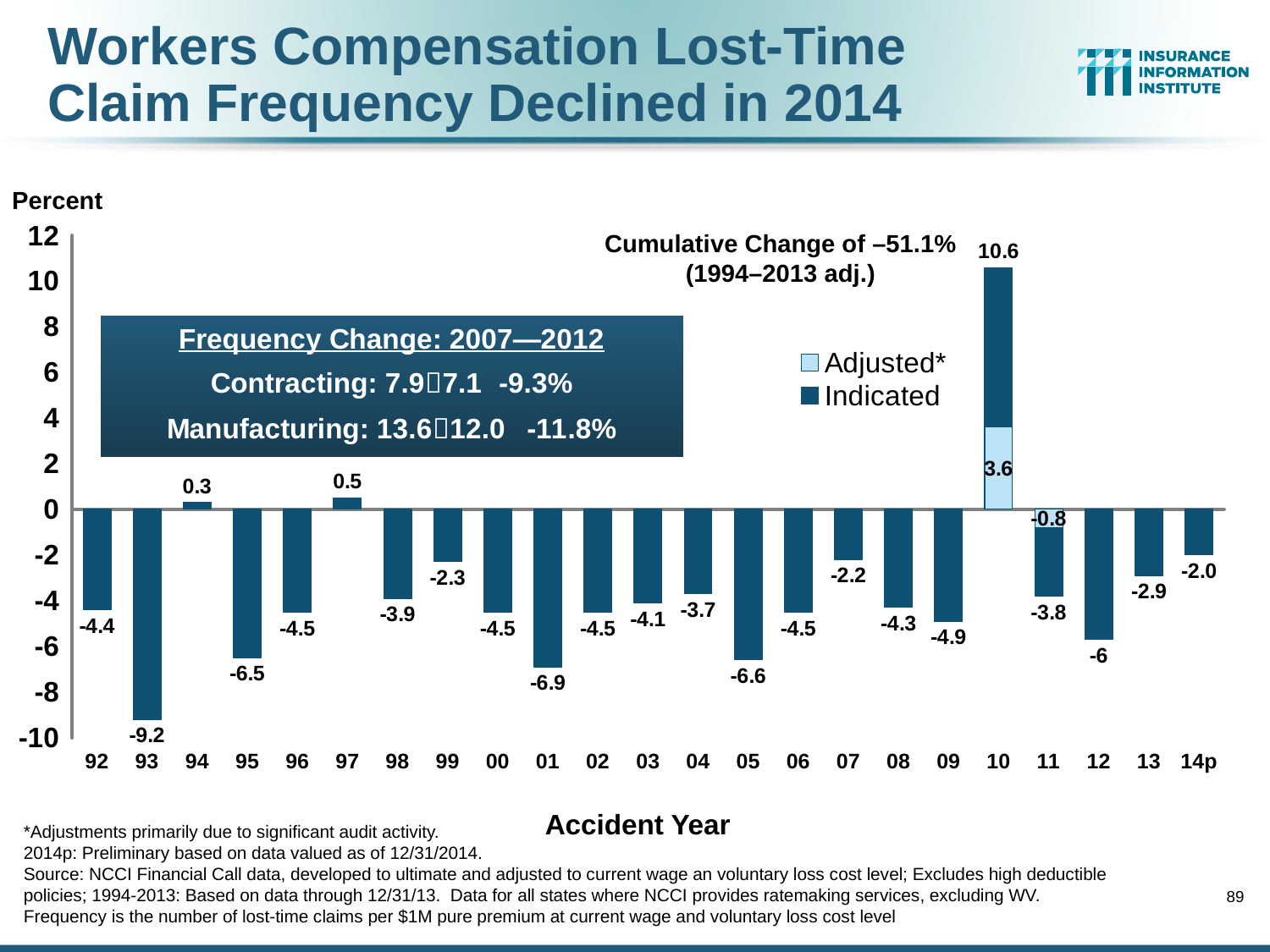
How many accident years are shown on the x axis? 23 What is the difference between the values for accident years 13 and 14p? 0.9 What is the value for accident year 93? -9.2 What is the value for accident year 14p? -2.0 How many series does the legend list? 2 Which is larger, the value for accident year 12 or for accident year 13? 13 What is the Indicated value for accident year 10? 10.6 What is the cumulative change stated on the chart for 1994–2013 (adj.)? –51.1% Which accident year has the lowest value? 93 Which accident year has the highest value? 10 What kind of chart is shown on the slide? Bar chart What is the Adjusted value for accident year 10? 3.6